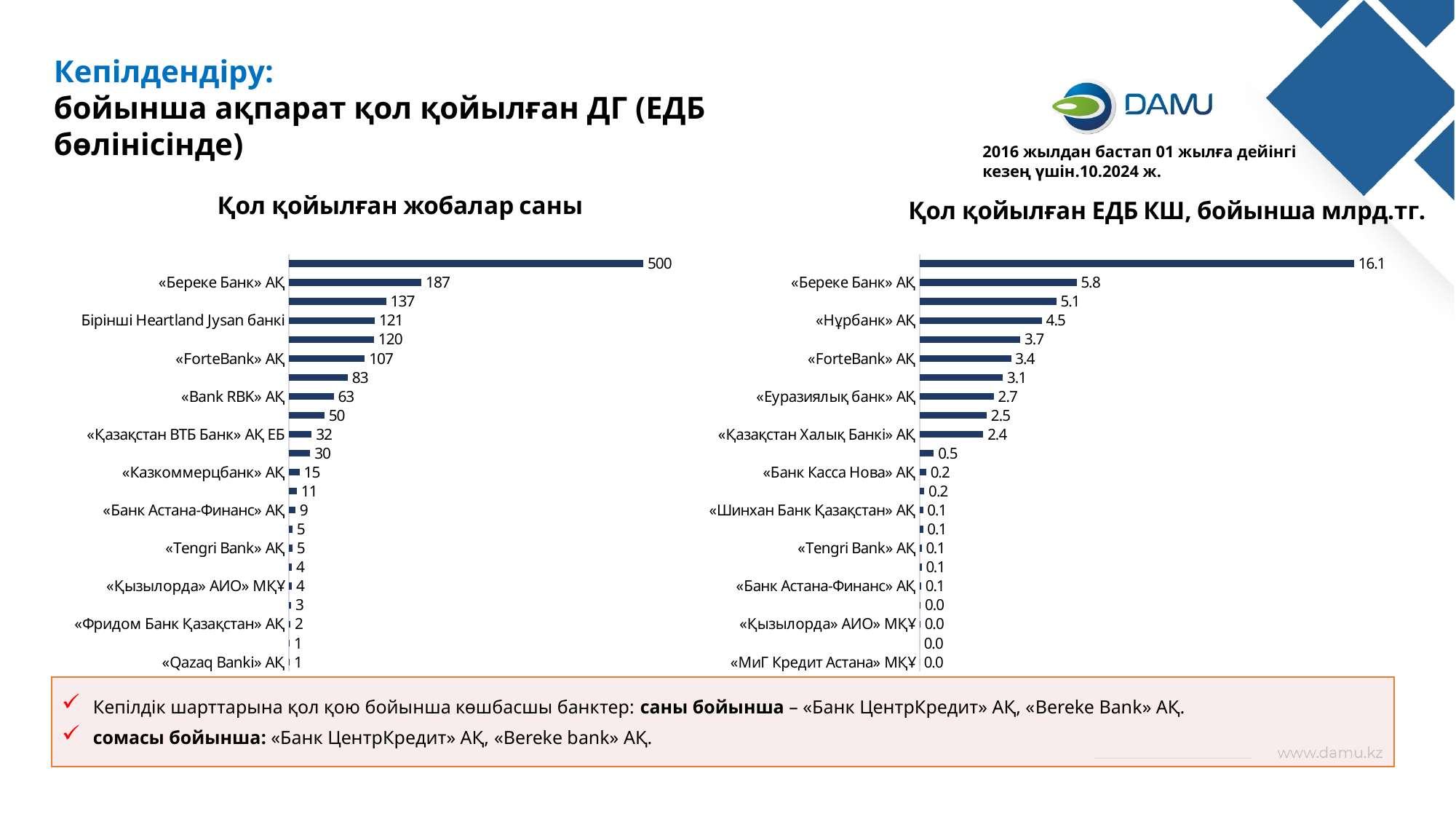
In the chart 'Қол қойылған жобалар саны', what is the value for «ForteBank» АҚ? 107 In the chart 'Қол қойылған жобалар саны', what is the value for «Береке Банк» АҚ? 187 In the chart 'Қол қойылған жобалар саны', what is the largest value shown on any bar? 500 In the chart 'Қол қойылған жобалар саны', which has a larger value: «Қазақстан ВТБ Банк» АҚ ЕБ or «Казкоммерцбанк» АҚ? «Қазақстан ВТБ Банк» АҚ ЕБ In the chart 'Қол қойылған ЕДБ КШ, бойынша млрд.тг.', what is the value for «Қазақстан Халық Банкі» АҚ? 2.4 How many bars are plotted in the chart 'Қол қойылған жобалар саны'? 22 In the chart 'Қол қойылған жобалар саны', what is the value for «Bank RBK» АҚ? 63 In the chart 'Қол қойылған ЕДБ КШ, бойынша млрд.тг.', what is the value for «Еуразиялық банк» АҚ? 2.7 In the chart 'Қол қойылған ЕДБ КШ, бойынша млрд.тг.', what is the difference between the values for «Береке Банк» АҚ and «ForteBank» АҚ? 2.4 In the chart 'Қол қойылған жобалар саны', what is the difference between the values for «Береке Банк» АҚ and Бірінші Heartland Jysan банкі? 66 In the chart 'Қол қойылған ЕДБ КШ, бойынша млрд.тг.', what is the value for «Нұрбанк» АҚ? 4.5 What type of chart is 'Қол қойылған ЕДБ КШ, бойынша млрд.тг.'? Bar chart